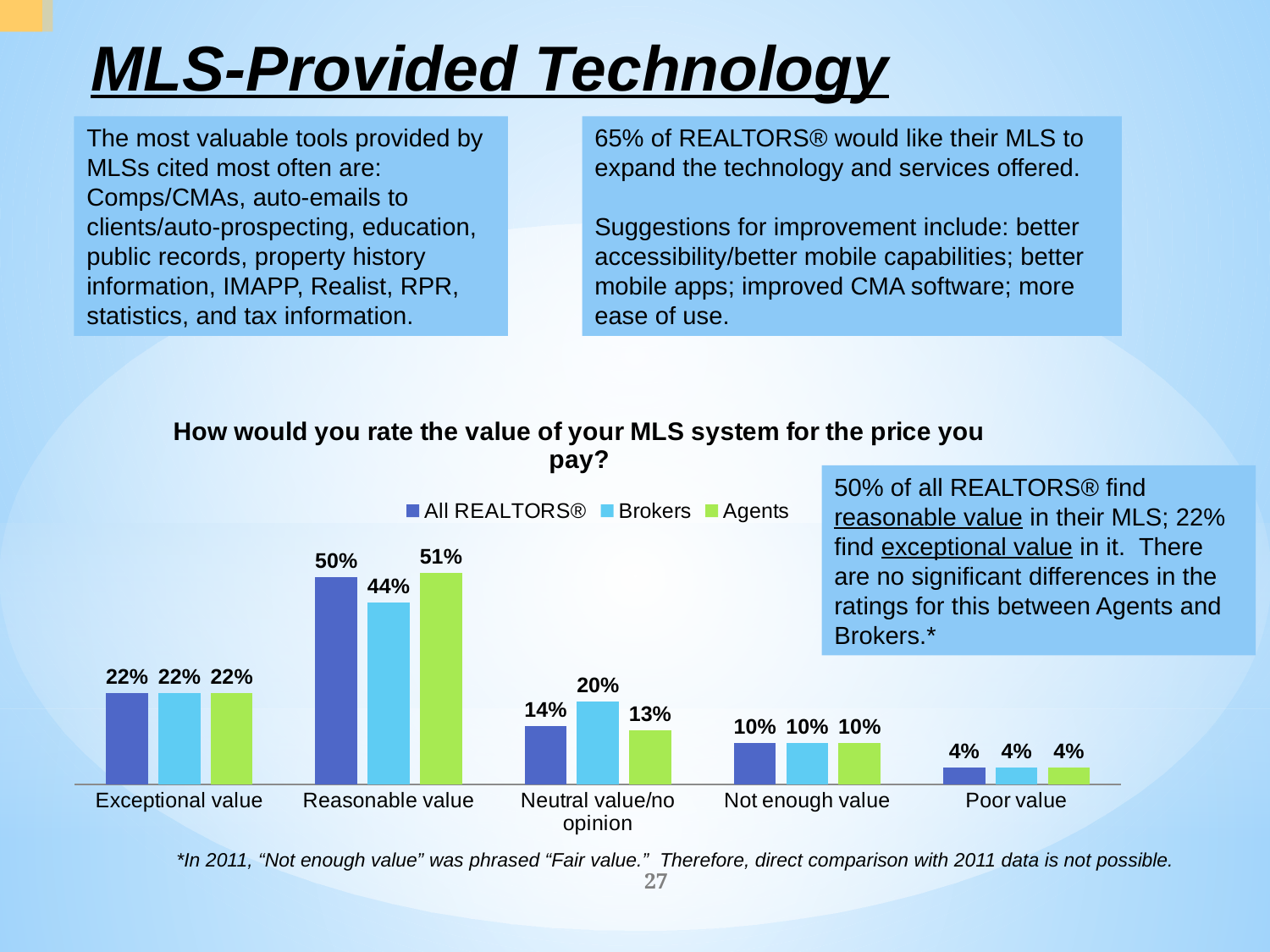
What is the difference between the Brokers and All REALTORS® values for Neutral value/no opinion? 6% What percentage of Agents rate their MLS system as Neutral value/no opinion? 13% What percentage of Brokers rate their MLS system as Reasonable value? 44% What is the title of the chart? How would you rate the value of your MLS system for the price you pay? How many rating categories are shown on the x axis? 5 How many series does the legend list? 3 What is the difference between the Agents and Brokers values for Reasonable value? 7% What kind of chart is shown on the slide? Bar chart In the Neutral value/no opinion category, which is larger: Brokers or All REALTORS®? Brokers Which category has the highest value for All REALTORS®? Reasonable value Which category has the lowest value for Agents? Poor value What is the value for All REALTORS® in the Exceptional value category? 22%